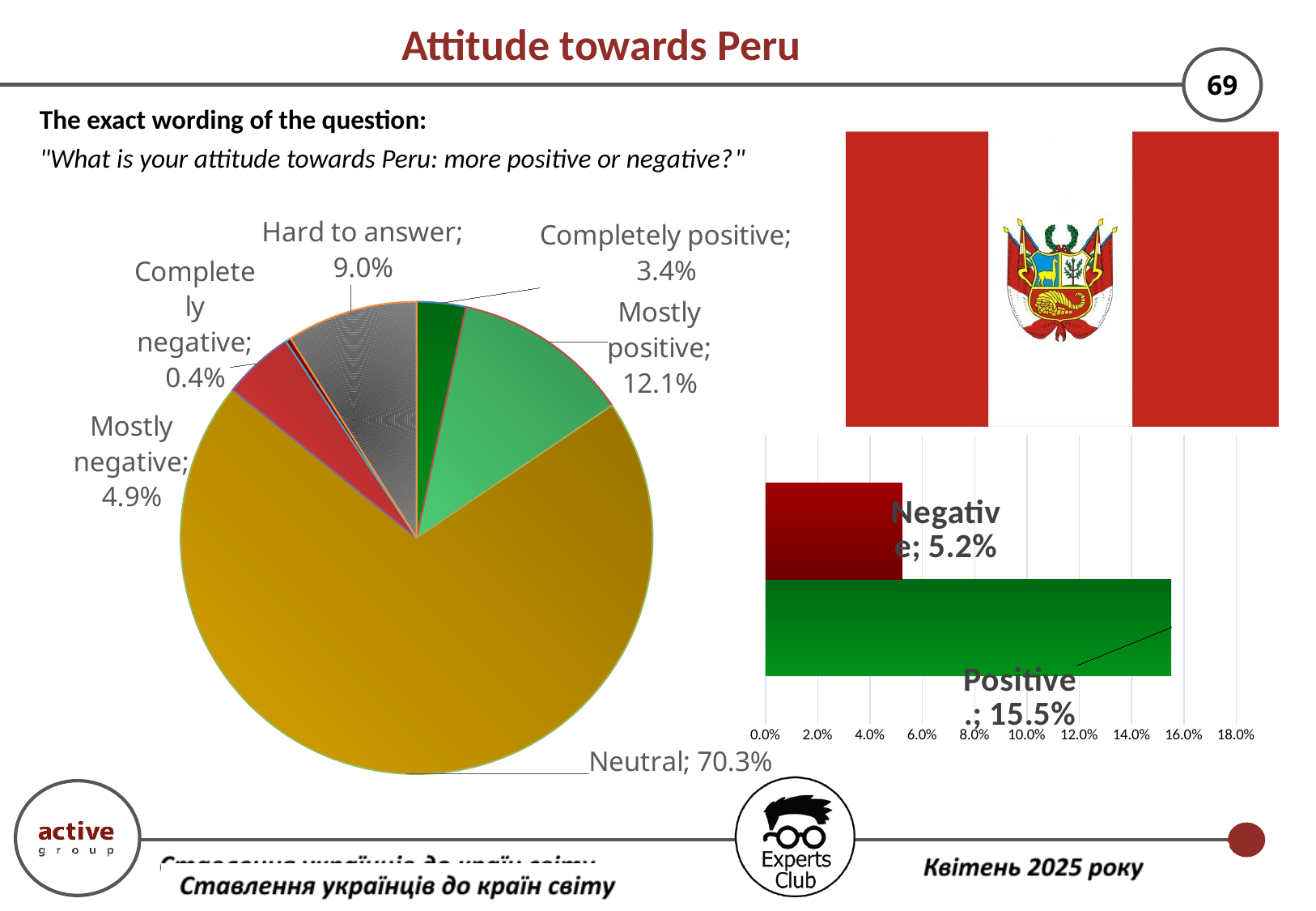
In the pie chart, how many categories are shown? 6 In the bar chart on the right, what is the value for "Positive"? 15.5% In the bar chart on the right, what is the difference between "Positive" and "Negative"? 10.3% In the pie chart, what is the difference between "Mostly positive" and "Mostly negative"? 7.2% In the pie chart, which category has the largest share? Neutral In the pie chart, what is the value for "Hard to answer"? 9.0% What type of chart is shown on the right side of the slide? Bar chart In the pie chart, which category has the smallest share? Completely negative In the pie chart, which is larger: "Hard to answer" or "Completely positive"? Hard to answer In the pie chart, what is the value for "Mostly positive"? 12.1% In the pie chart, what share of respondents answered "Neutral"? 70.3% In the bar chart on the right, what is the value for "Negative"? 5.2%